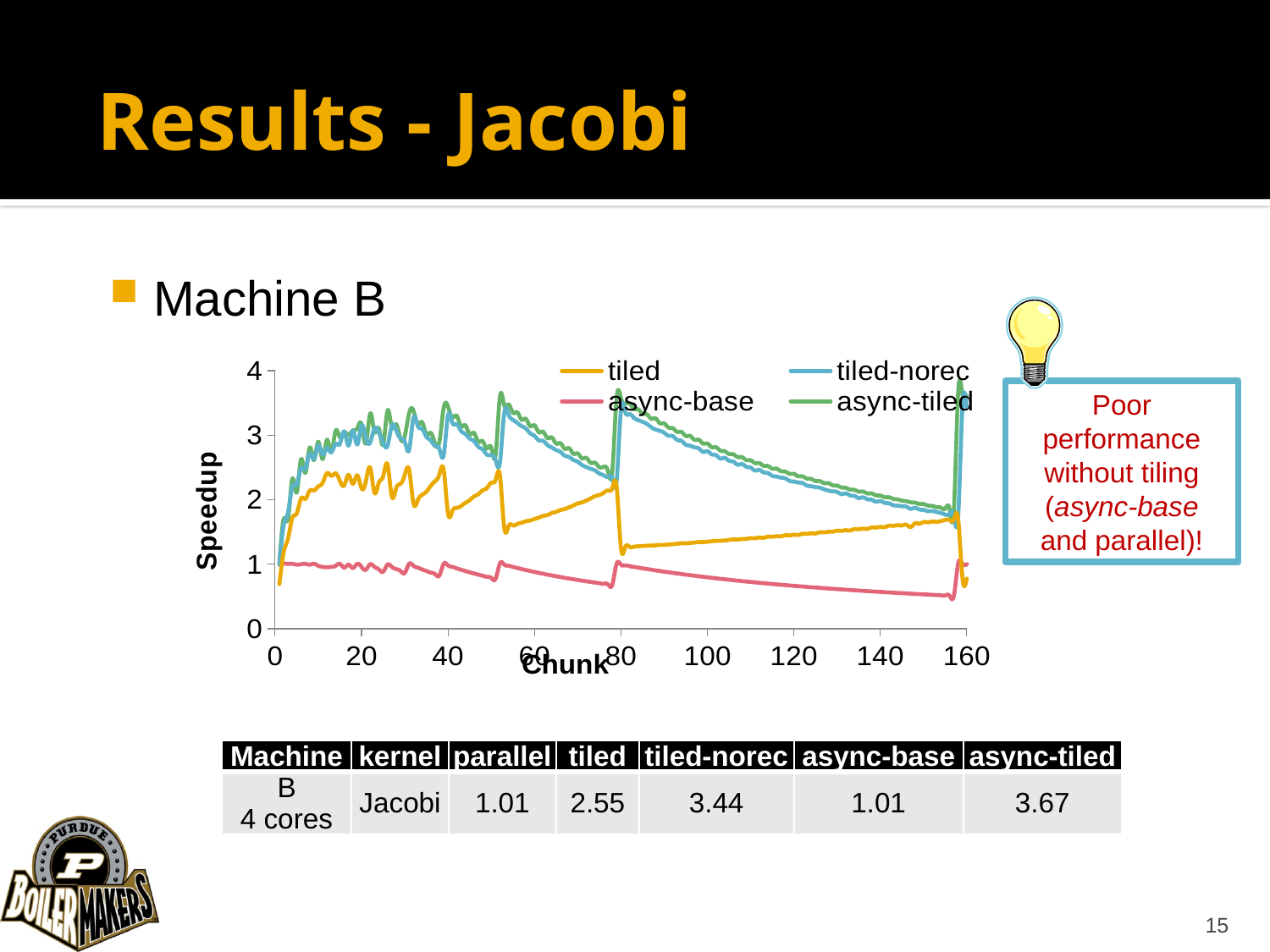
What is the title of the chart's vertical axis? Speedup Between chunk 80 and chunk 150, does the speedup for tiled rise or fall? rise Is the speedup for async-tiled at chunk 100 greater or less than 2? greater Is the speedup for async-base at chunk 120 greater or less than 1? less Is the speedup for tiled-norec just after chunk 80 greater or less than 3? greater What is the title of the chart's horizontal axis? Chunk What kind of chart is shown on the slide? line chart How many series does the chart's legend list? 4 At chunk 100, which series has the higher speedup, async-tiled or tiled? async-tiled Between chunk 80 and chunk 150, does the speedup for async-base rise or fall? fall